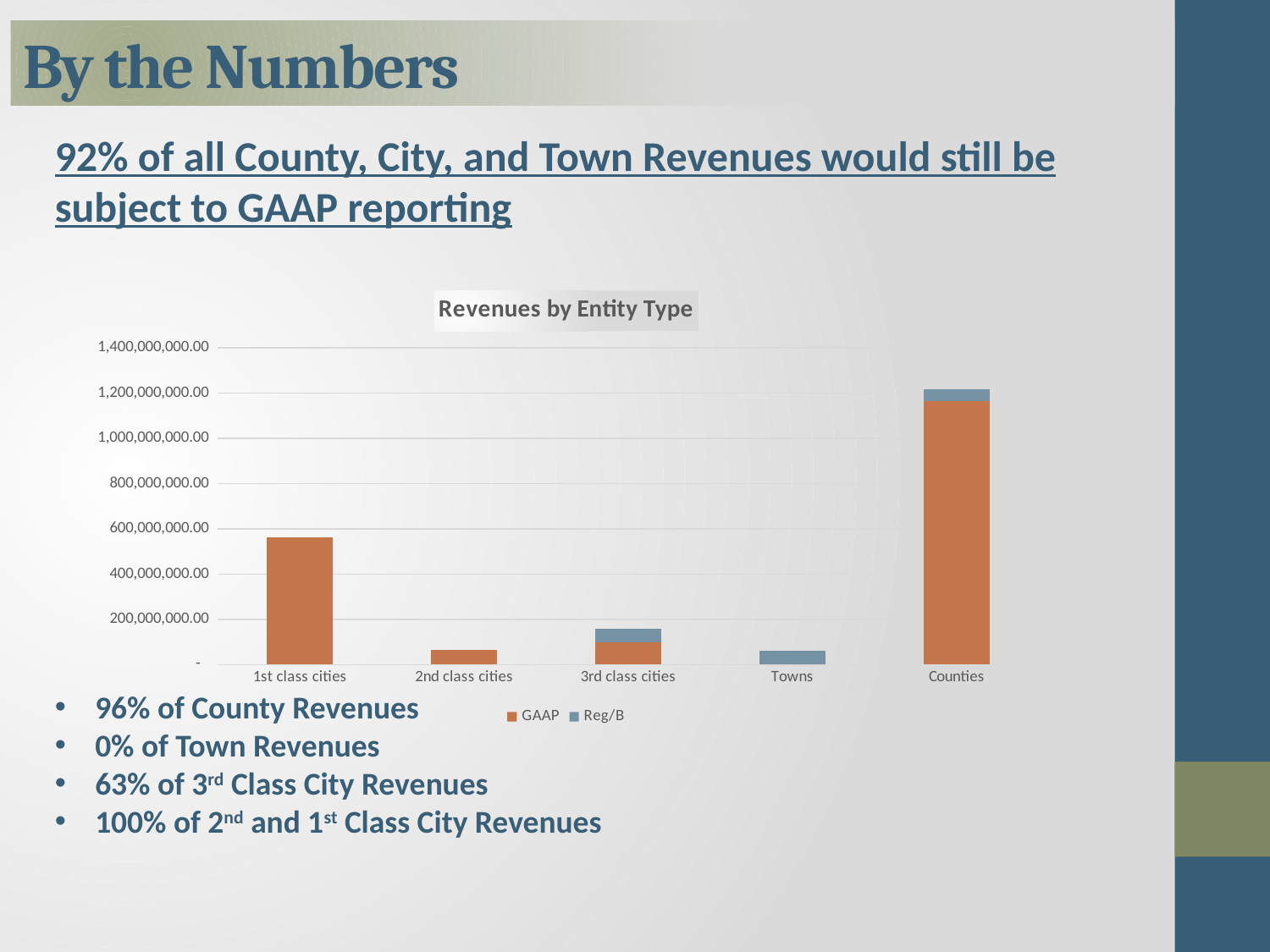
Which entity type has the highest total revenue in the chart? Counties What kind of chart is shown on the slide? Stacked bar chart What is the title of the chart? Revenues by Entity Type Is the GAAP revenue for 1st class cities greater or less than 600,000,000.00? less Which has larger total revenue, 1st class cities or 3rd class cities? 1st class cities Is the total revenue for 3rd class cities greater or less than 200,000,000.00? less Is the total revenue for Counties greater or less than 1,000,000,000.00? greater Which has larger total revenue, Counties or 1st class cities? Counties How many series does the chart legend list? 2 How many entity type categories are shown on the x axis of the chart? 5 Which entity type shows only Reg/B revenue and no GAAP revenue in the chart? Towns